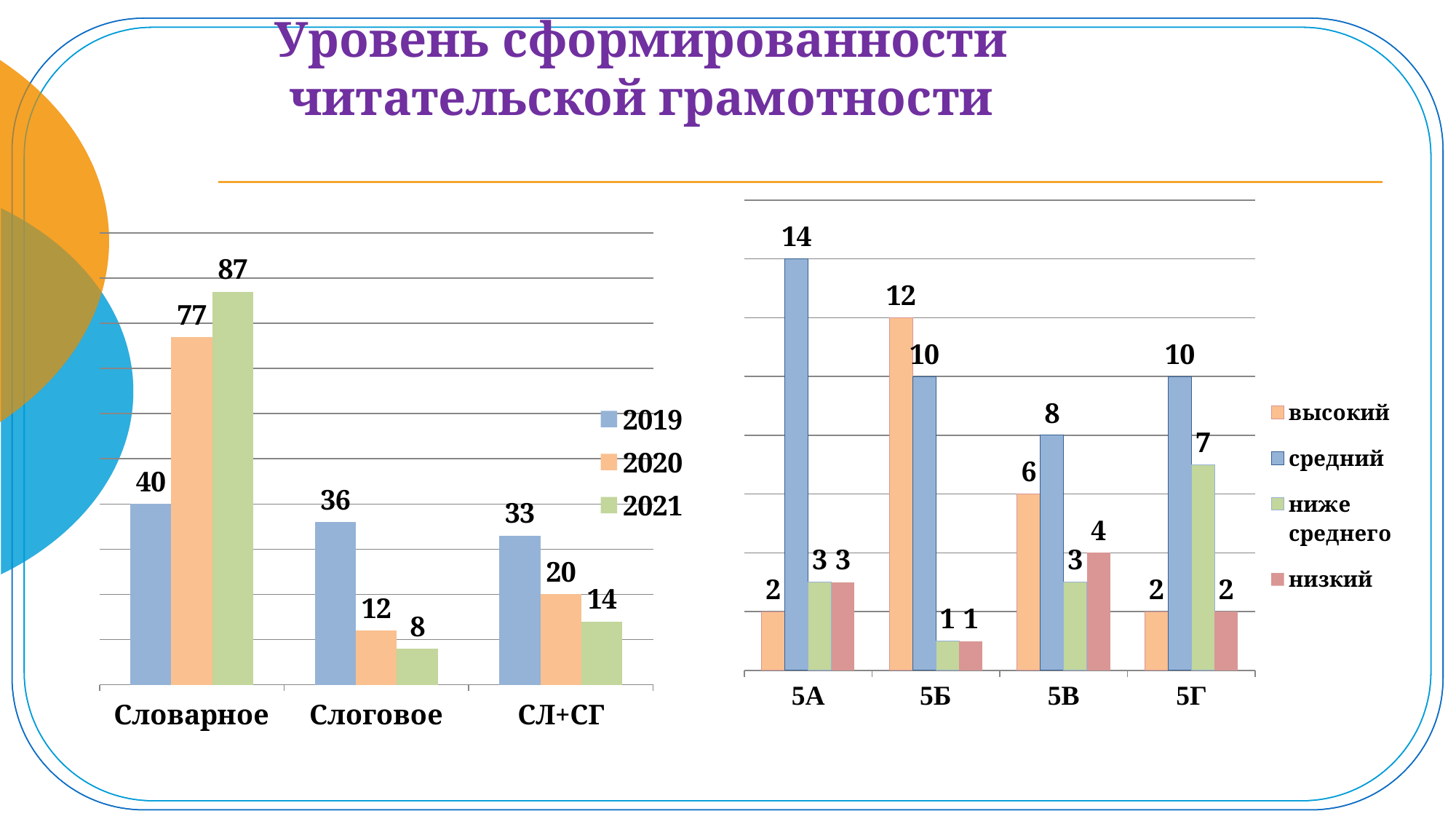
In the right chart, how many classes are shown on the x axis? 4 In the left chart, do the values for Слоговое rise or fall from 2019 to 2021? fall In the left chart, which category has the highest value for 2019? Словарное In the right chart, what is the value for средний in 5А? 14 In the right chart, is the value for высокий in 5В larger or smaller than the value for средний in 5В? smaller In the left chart, how many series does the legend list? 3 In the left chart, what is the difference between the 2021 and 2019 values for Словарное? 47 In the left chart, what is the value for Словарное in 2021? 87 In the right chart, what is the value for высокий in 5Б? 12 In the left chart, which category has the lowest value for 2021? Слоговое In the right chart, which class has the highest value for ниже среднего? 5Г In the left chart, what is the value for Слоговое in 2020? 12